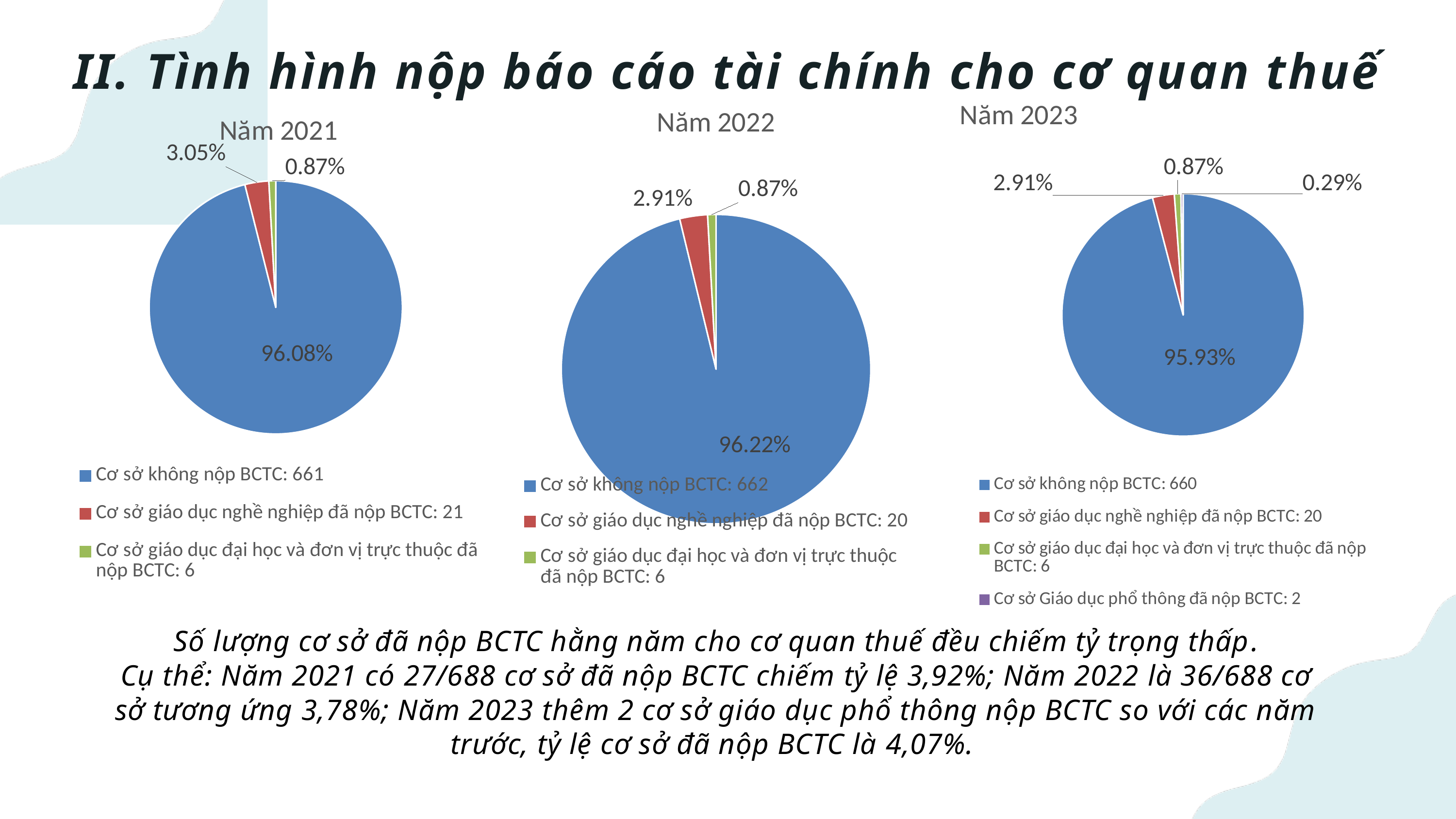
In the Năm 2023 chart, what share is shown for Cơ sở Giáo dục phổ thông đã nộp BCTC? 0.29% According to the legend of the Năm 2023 chart, how many Cơ sở không nộp BCTC are there? 660 In the Năm 2023 chart, which category has the largest slice? Cơ sở không nộp BCTC In the Năm 2022 chart, what share is shown for Cơ sở giáo dục đại học và đơn vị trực thuộc đã nộp BCTC? 0.87% In the Năm 2021 chart, what is the difference between the share for Cơ sở giáo dục nghề nghiệp đã nộp BCTC and the share for Cơ sở giáo dục đại học và đơn vị trực thuộc đã nộp BCTC? 2.18% In the Năm 2022 chart, what share is shown for Cơ sở giáo dục nghề nghiệp đã nộp BCTC? 2.91% How many slices does the Năm 2021 pie chart have? 3 In the Năm 2023 chart, which category has the smallest slice? Cơ sở Giáo dục phổ thông đã nộp BCTC In the Năm 2021 chart, what share is shown for Cơ sở không nộp BCTC? 96.08% How many slices does the Năm 2023 pie chart have? 4 What kind of chart is used for Năm 2021? Pie chart Which chart shows a larger share for Cơ sở không nộp BCTC, Năm 2021 or Năm 2022? Năm 2022